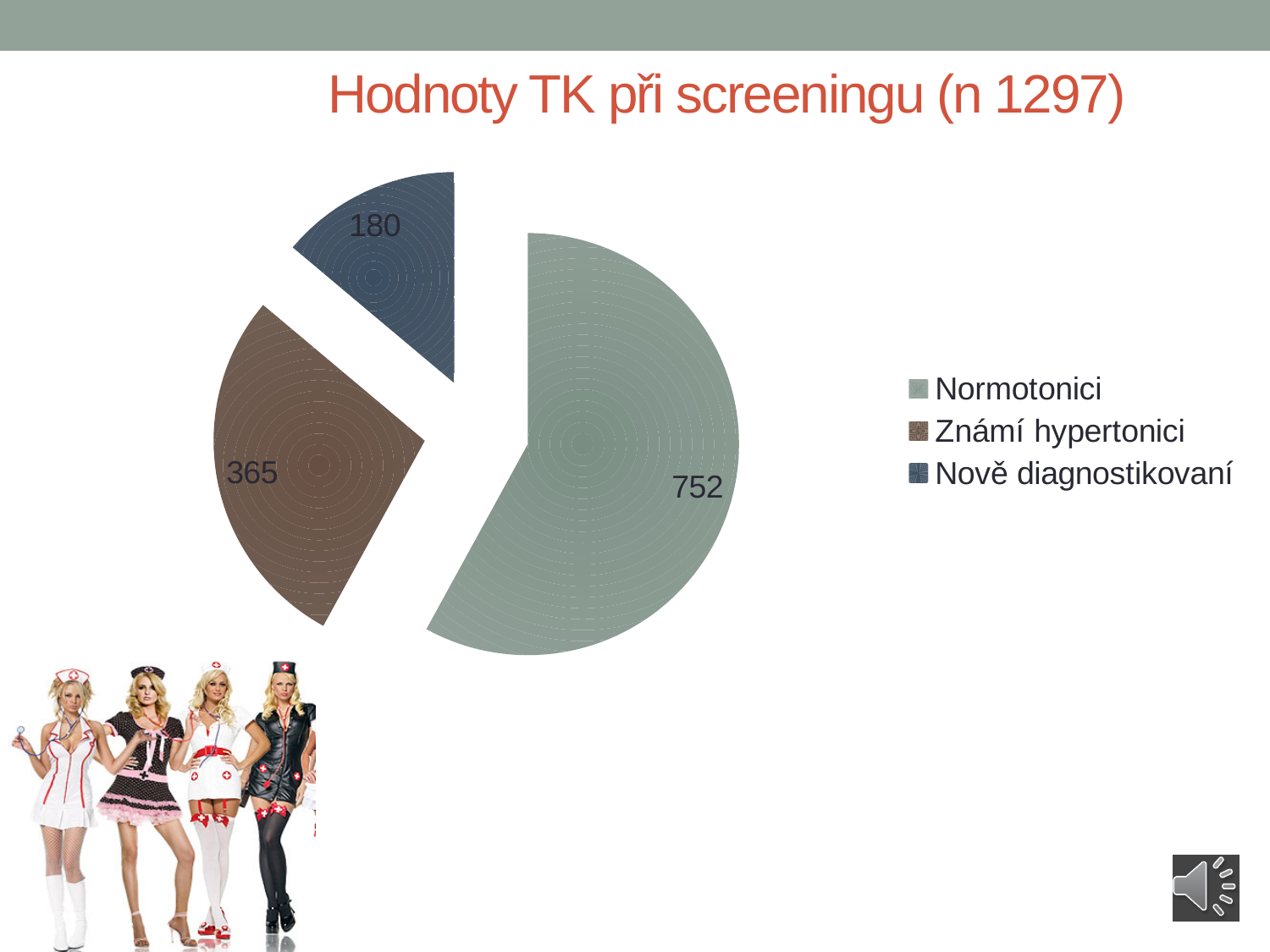
What type of chart is shown on the slide? pie chart What is the difference between the values for Známí hypertonici and Nově diagnostikovaní? 185 Which is larger, Známí hypertonici or Nově diagnostikovaní? Známí hypertonici What is the value for Známí hypertonici? 365 Which category has the largest slice of the pie? Normotonici What is the title of the pie chart? Hodnoty TK při screeningu (n 1297) What is the total of all three slices in the pie chart? 1297 What is the value for Normotonici? 752 How many slices does the pie chart have? 3 What is the value for Nově diagnostikovaní? 180 Which category has the smallest slice of the pie? Nově diagnostikovaní What is the difference between the values for Normotonici and Známí hypertonici? 387